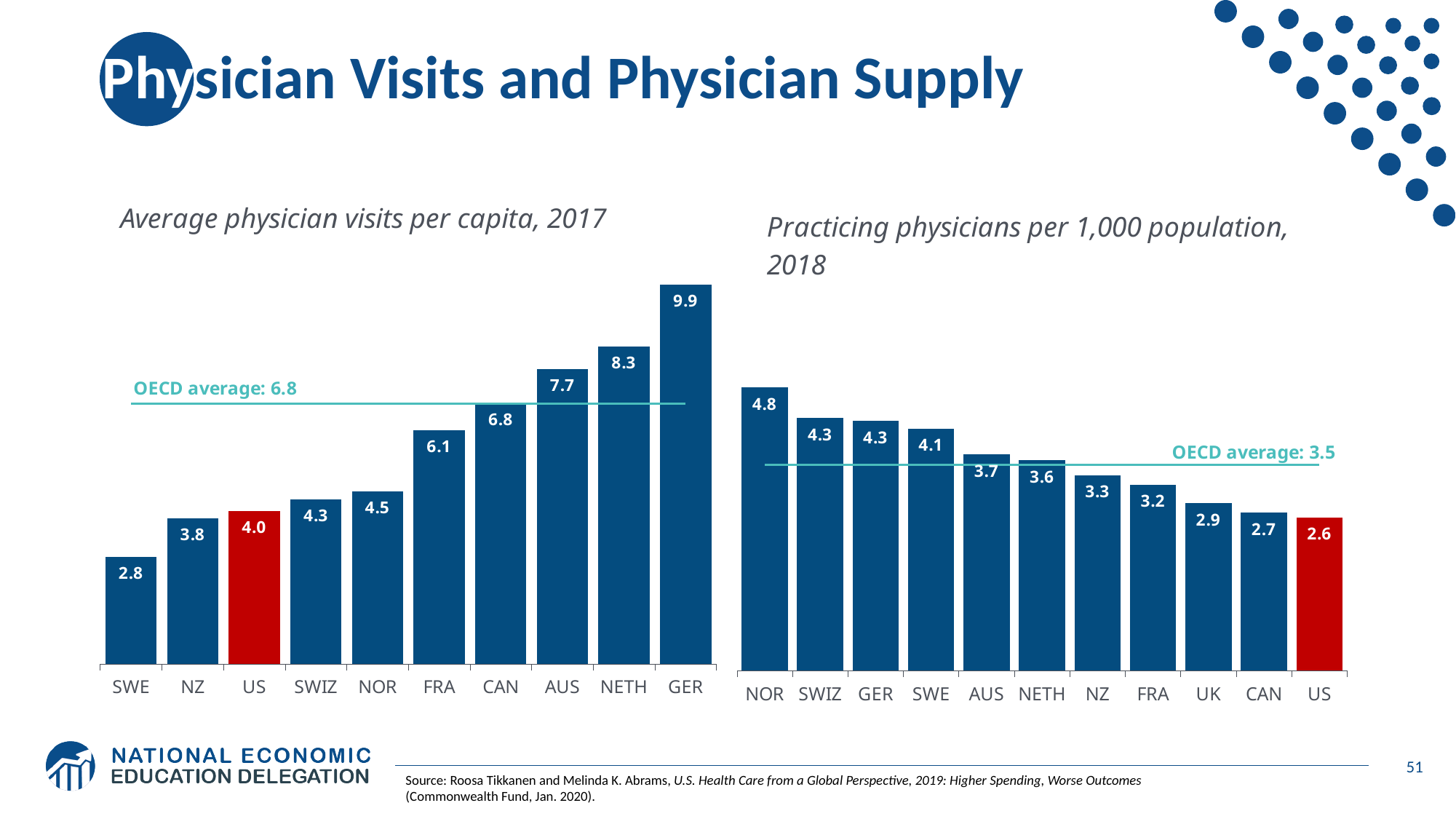
In the 'Average physician visits per capita, 2017' chart, what is the value for the US? 4.0 In the 'Average physician visits per capita, 2017' chart, what OECD average is shown? 6.8 In the 'Average physician visits per capita, 2017' chart, which country has the highest value? GER In the 'Average physician visits per capita, 2017' chart, which country has the lowest value? SWE In the 'Practicing physicians per 1,000 population, 2018' chart, what is the value for NOR? 4.8 In the 'Practicing physicians per 1,000 population, 2018' chart, which country has the lowest value? US What type of chart is the 'Practicing physicians per 1,000 population, 2018' chart? Bar chart In the 'Average physician visits per capita, 2017' chart, what is the difference between GER and NETH? 1.6 In the 'Practicing physicians per 1,000 population, 2018' chart, which is larger, the value for UK or the value for CAN? UK In the 'Practicing physicians per 1,000 population, 2018' chart, what is the difference between NOR and US? 2.2 In the 'Practicing physicians per 1,000 population, 2018' chart, how many countries are shown? 11 In the 'Average physician visits per capita, 2017' chart, how many countries are shown? 10